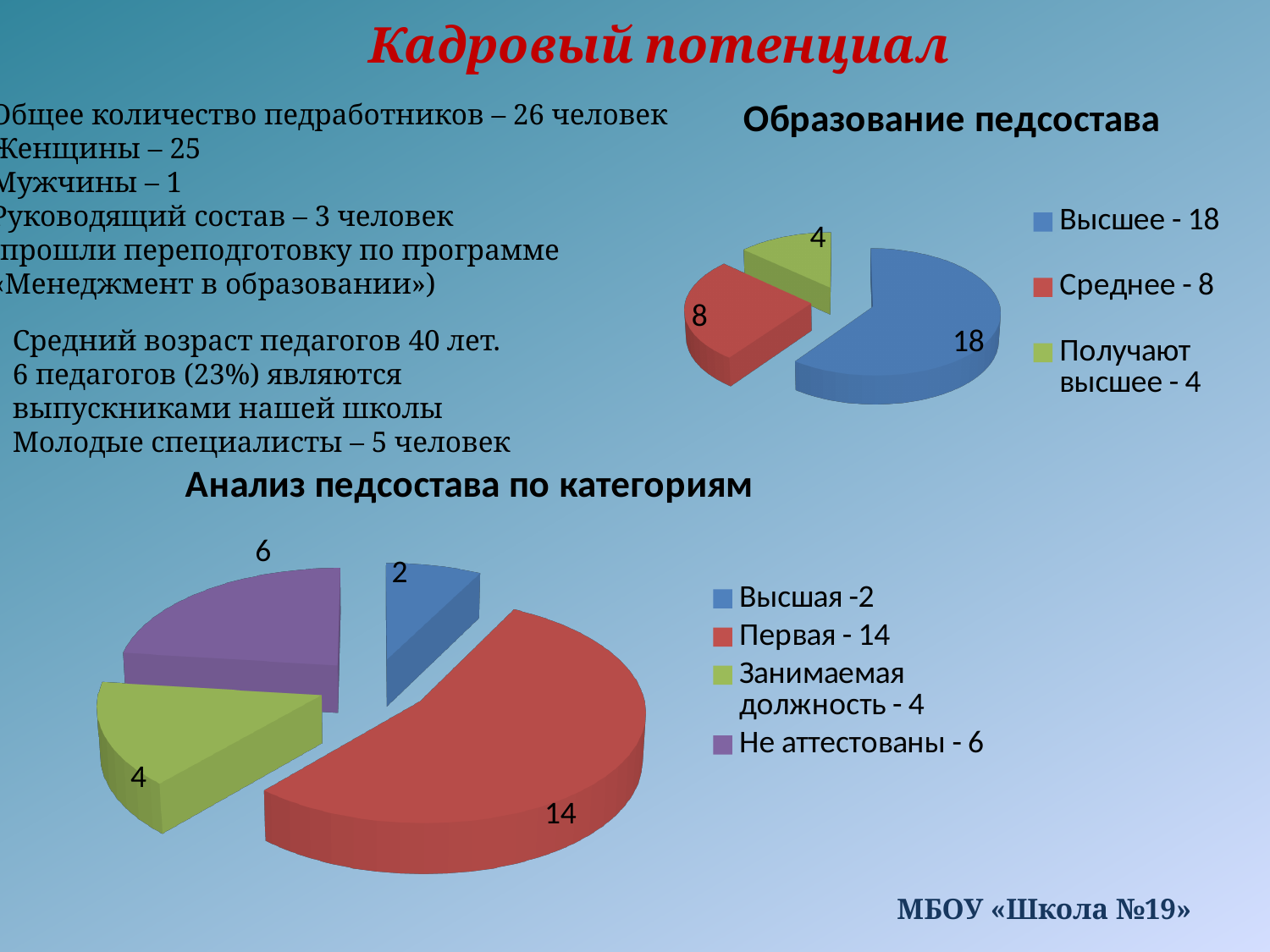
In the chart titled "Анализ педсостава по категориям", what is the value for "Не аттестованы"? 6 In the chart titled "Анализ педсостава по категориям", which is larger: "Занимаемая должность" or "Не аттестованы"? Не аттестованы In the chart titled "Образование педсостава", what share of the pie does "Высшее" represent? 60% In the chart titled "Анализ педсостава по категориям", which category has the smallest slice? Высшая In the chart titled "Образование педсостава", what is the difference between the values for "Высшее" and "Среднее"? 10 In the chart titled "Анализ педсостава по категориям", how many categories does the legend list? 4 In the chart titled "Образование педсостава", how many slices does the pie have? 3 In the chart titled "Образование педсостава", what is the value for "Получают высшее"? 4 In the chart titled "Образование педсостава", which category has the largest slice? Высшее In the chart titled "Образование педсостава", what is the value for "Высшее"? 18 What type of chart is "Анализ педсостава по категориям"? Pie chart In the chart titled "Анализ педсостава по категориям", what is the value for "Первая"? 14